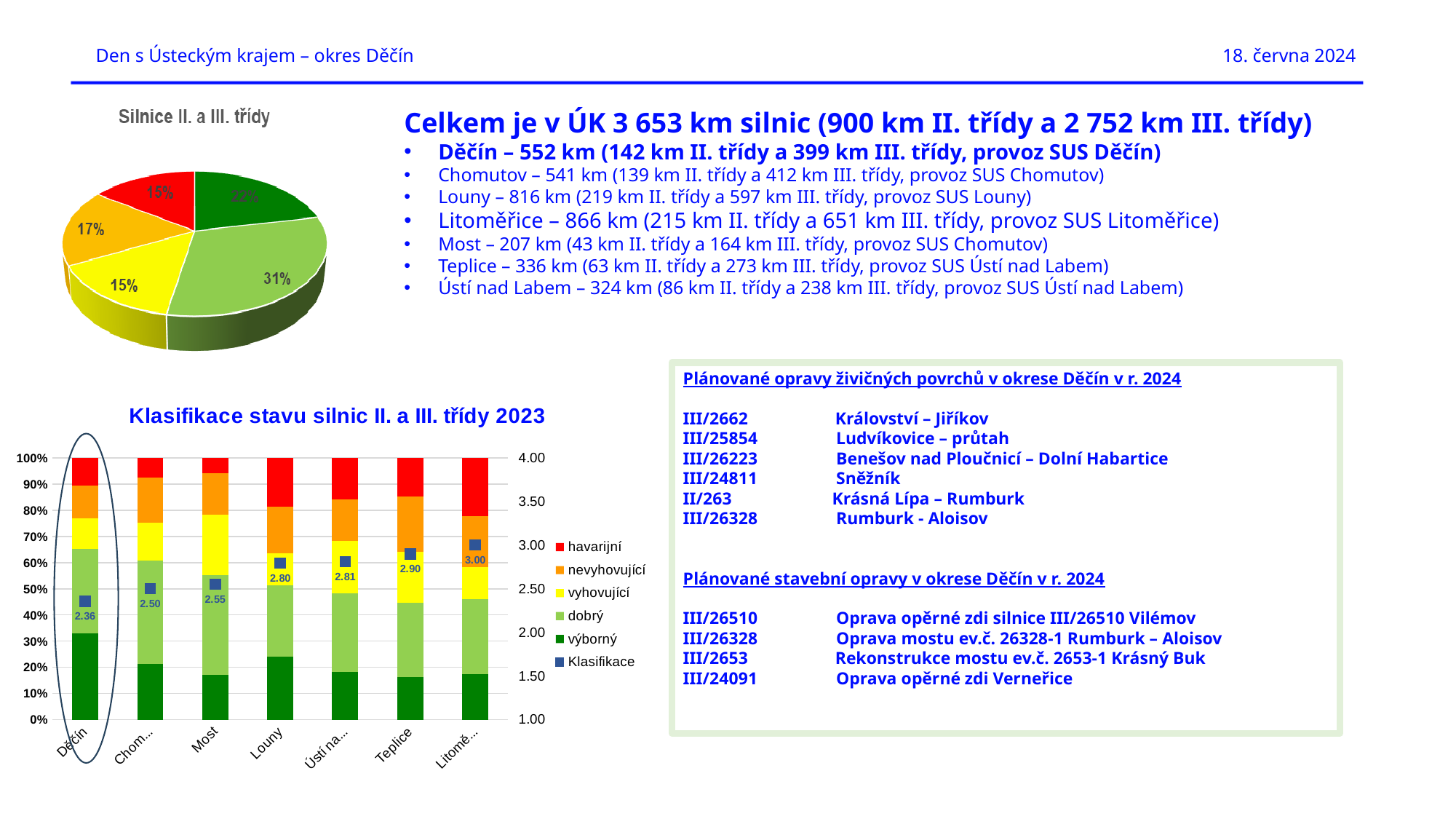
In the chart "Klasifikace stavu silnic II. a III. třídy 2023", what is the Klasifikace value for Děčín? 2.36 In the chart "Klasifikace stavu silnic II. a III. třídy 2023", how many districts are shown on the x axis? 7 In the chart "Klasifikace stavu silnic II. a III. třídy 2023", what is the Klasifikace value for Teplice? 2.90 What type of chart is "Klasifikace stavu silnic II. a III. třídy 2023"? bar chart In the chart "Klasifikace stavu silnic II. a III. třídy 2023", which district has the lowest Klasifikace value? Děčín In the pie chart "Silnice II. a III. třídy", what is the share of the largest slice? 31% In the pie chart "Silnice II. a III. třídy", how many slices are there? 5 In the chart "Klasifikace stavu silnic II. a III. třídy 2023", which district has the highest Klasifikace value? Litomě... (Litoměřice) What type of chart is the chart titled "Silnice II. a III. třídy"? pie chart In the chart "Klasifikace stavu silnic II. a III. třídy 2023", how many entries does the legend list? 6 In the pie chart "Silnice II. a III. třídy", what is the share of the smallest slice? 15% In the chart "Klasifikace stavu silnic II. a III. třídy 2023", what is the difference between the Klasifikace values of Teplice and Děčín? 0.54